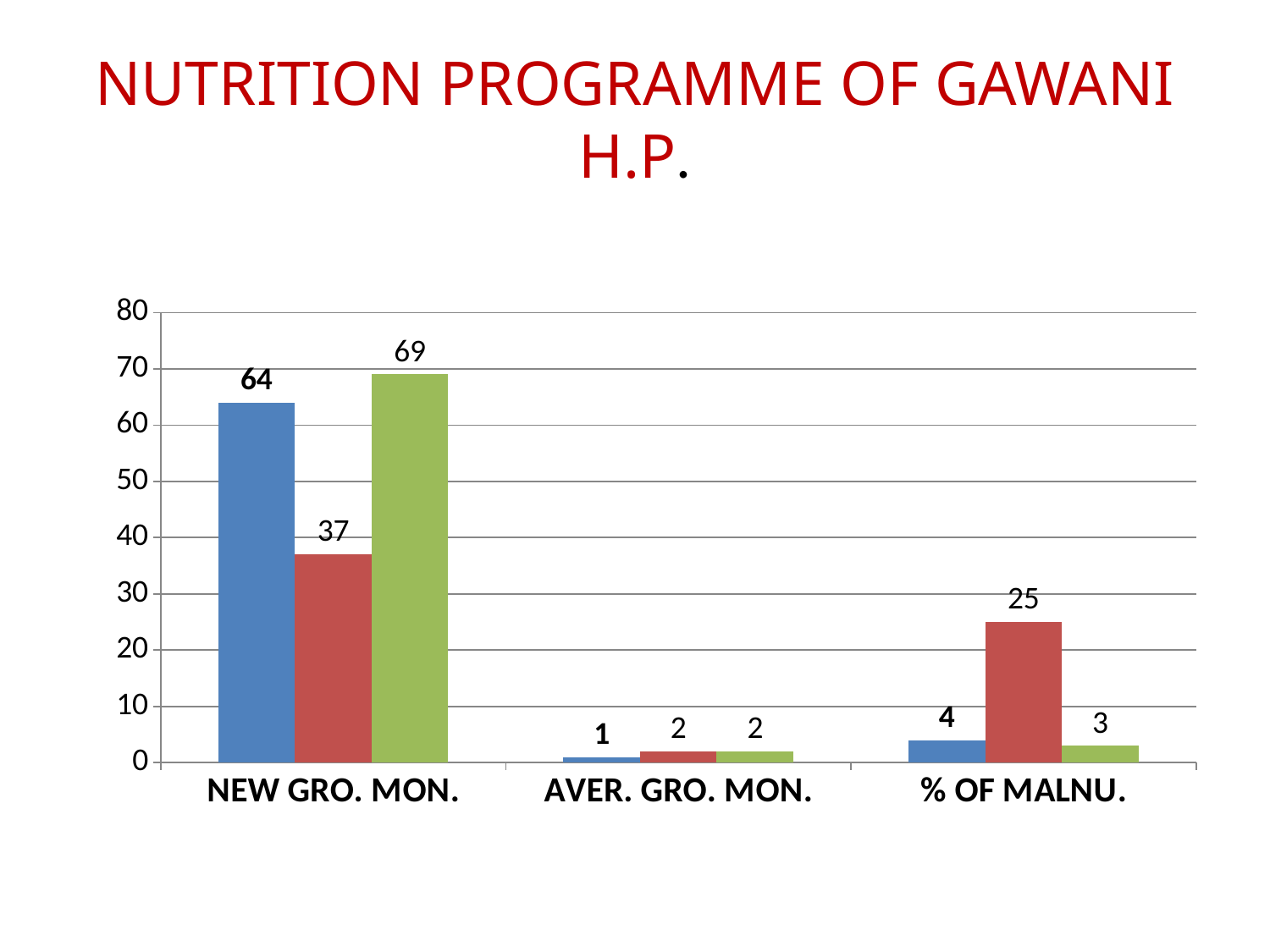
Which category has the lowest blue bar? AVER. GRO. MON. Which category has the highest green bar? NEW GRO. MON. For % OF MALNU., which is larger, the red bar or the green bar? the red bar What kind of chart is shown on the slide? bar chart What is the value of the green bar for NEW GRO. MON.? 69 What is the value of the blue bar for AVER. GRO. MON.? 1 What is the value of the red bar for % OF MALNU.? 25 What is the difference between the green bar and the red bar for NEW GRO. MON.? 32 Is the value of the red bar for NEW GRO. MON. greater or less than 40? less What is the value of the blue bar for NEW GRO. MON.? 64 What is the title of the slide? NUTRITION PROGRAMME OF GAWANI H.P. How many categories are shown on the x axis? 3